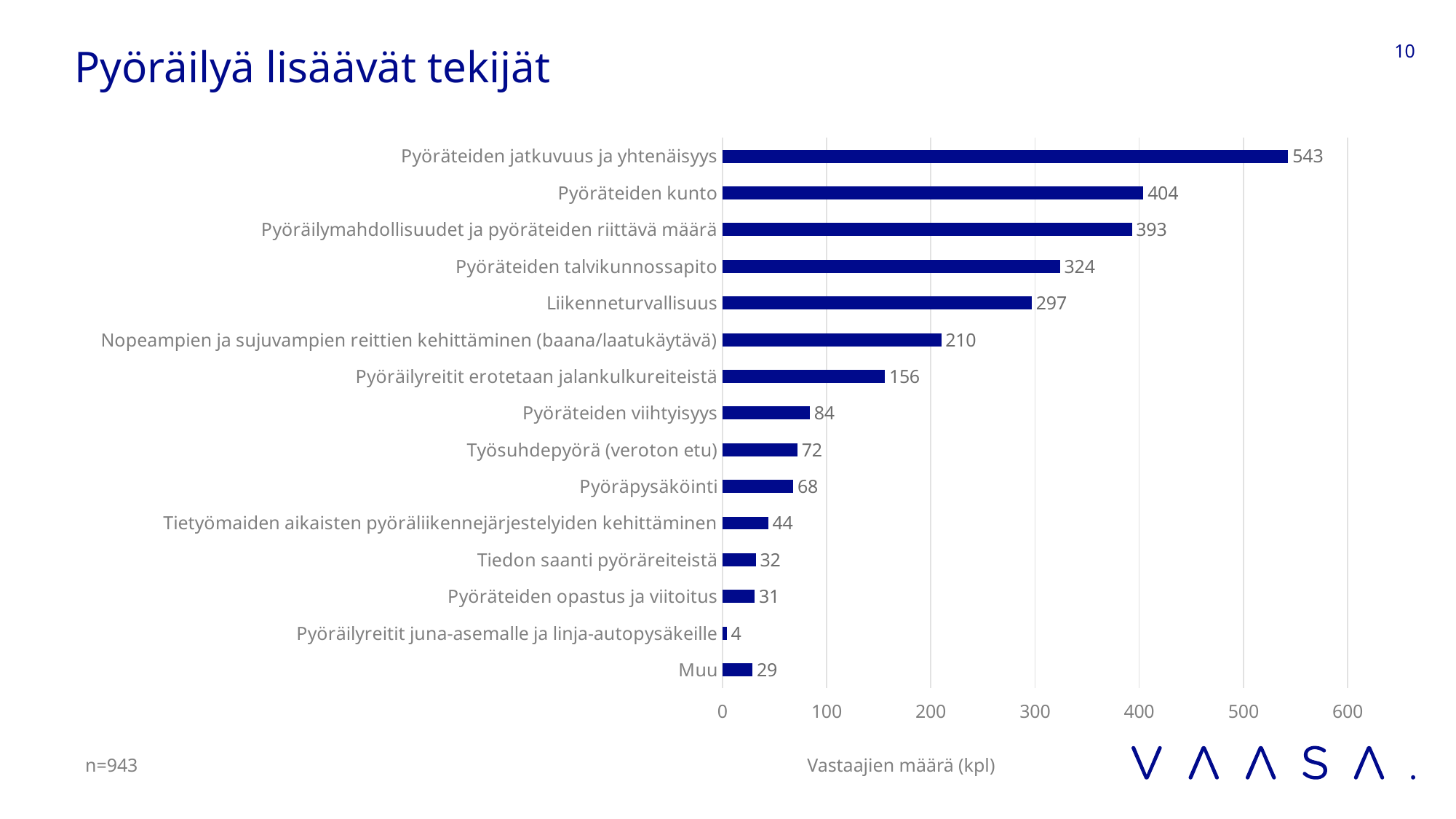
What is the title of the slide? Pyöräilyä lisäävät tekijät What is the label of the horizontal axis? Vastaajien määrä (kpl) What is the difference between the values for Pyöräteiden jatkuvuus ja yhtenäisyys and Pyöräteiden kunto? 139 What is the value for Työsuhdepyörä (veroton etu)? 72 Which category has the highest value? Pyöräteiden jatkuvuus ja yhtenäisyys Which is larger: the value for Pyöräteiden talvikunnossapito or the value for Liikenneturvallisuus? Pyöräteiden talvikunnossapito What is the value for Liikenneturvallisuus? 297 How many categories are shown in the chart? 15 What kind of chart is shown on the slide? bar chart Is the value for Nopeampien ja sujuvampien reittien kehittäminen (baana/laatukäytävä) greater or less than 200? greater What is the value for Pyöräteiden kunto? 404 Which category has the lowest value? Pyöräilyreitit juna-asemalle ja linja-autopysäkeille